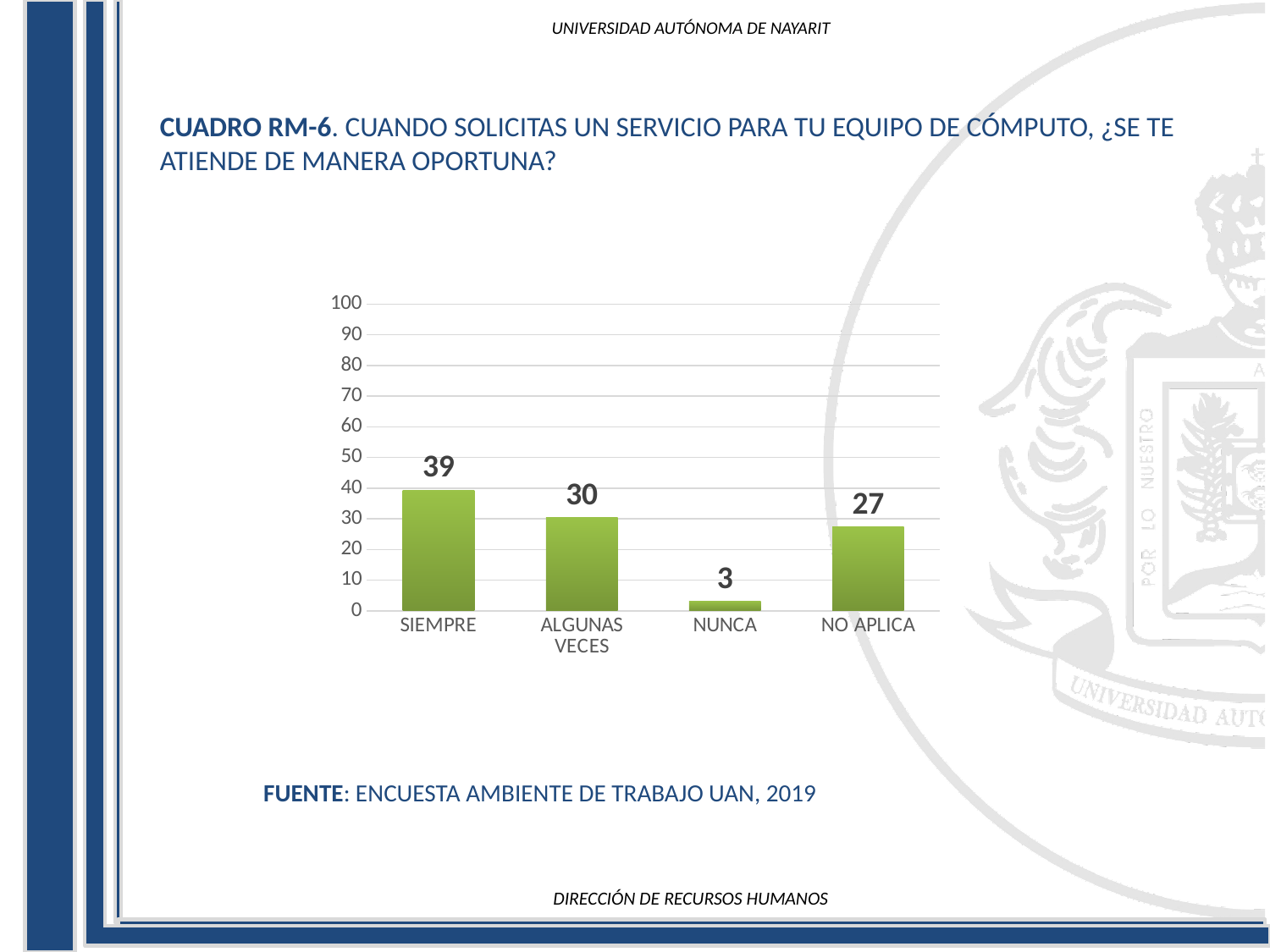
What is the value for NUNCA? 3 Which category has the lowest value? NUNCA What is the difference between the values for SIEMPRE and NO APLICA? 12 Which category has the highest value? SIEMPRE Is the value for SIEMPRE greater or less than 50? less Which is larger, the value for ALGUNAS VECES or the value for NO APLICA? ALGUNAS VECES What is the value for ALGUNAS VECES? 30 What is the value for SIEMPRE? 39 What kind of chart is shown on the slide? bar chart What is the value for NO APLICA? 27 What is the difference between the values for ALGUNAS VECES and NUNCA? 27 How many categories are shown on the x axis? 4